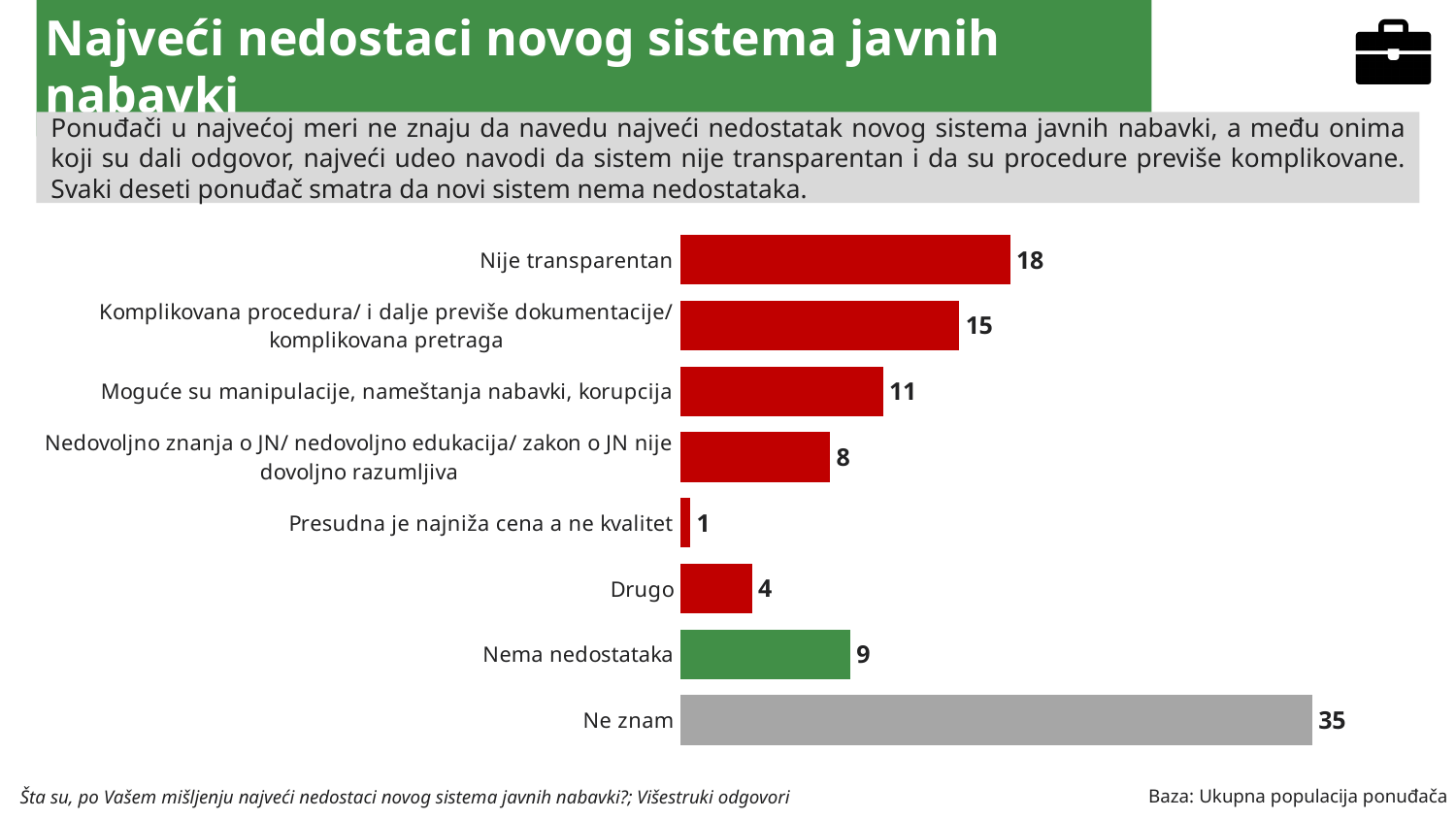
What kind of chart is shown on the slide? Bar chart Which category has the highest value? Ne znam What is the value for "Nema nedostataka"? 9 What is the difference between the values for "Nije transparentan" and "Komplikovana procedura/ i dalje previše dokumentacije/ komplikovana pretraga"? 3 How many categories are shown in the chart? 8 What is the value for "Presudna je najniža cena a ne kvalitet"? 1 Which category has the lowest value? Presudna je najniža cena a ne kvalitet What is the difference between the values for "Ne znam" and "Nije transparentan"? 17 What is the value for "Nije transparentan"? 18 What colour is the bar for "Nema nedostataka"? Green Which is larger: the value for "Drugo" or the value for "Nema nedostataka"? Nema nedostataka What is the value for "Ne znam"? 35